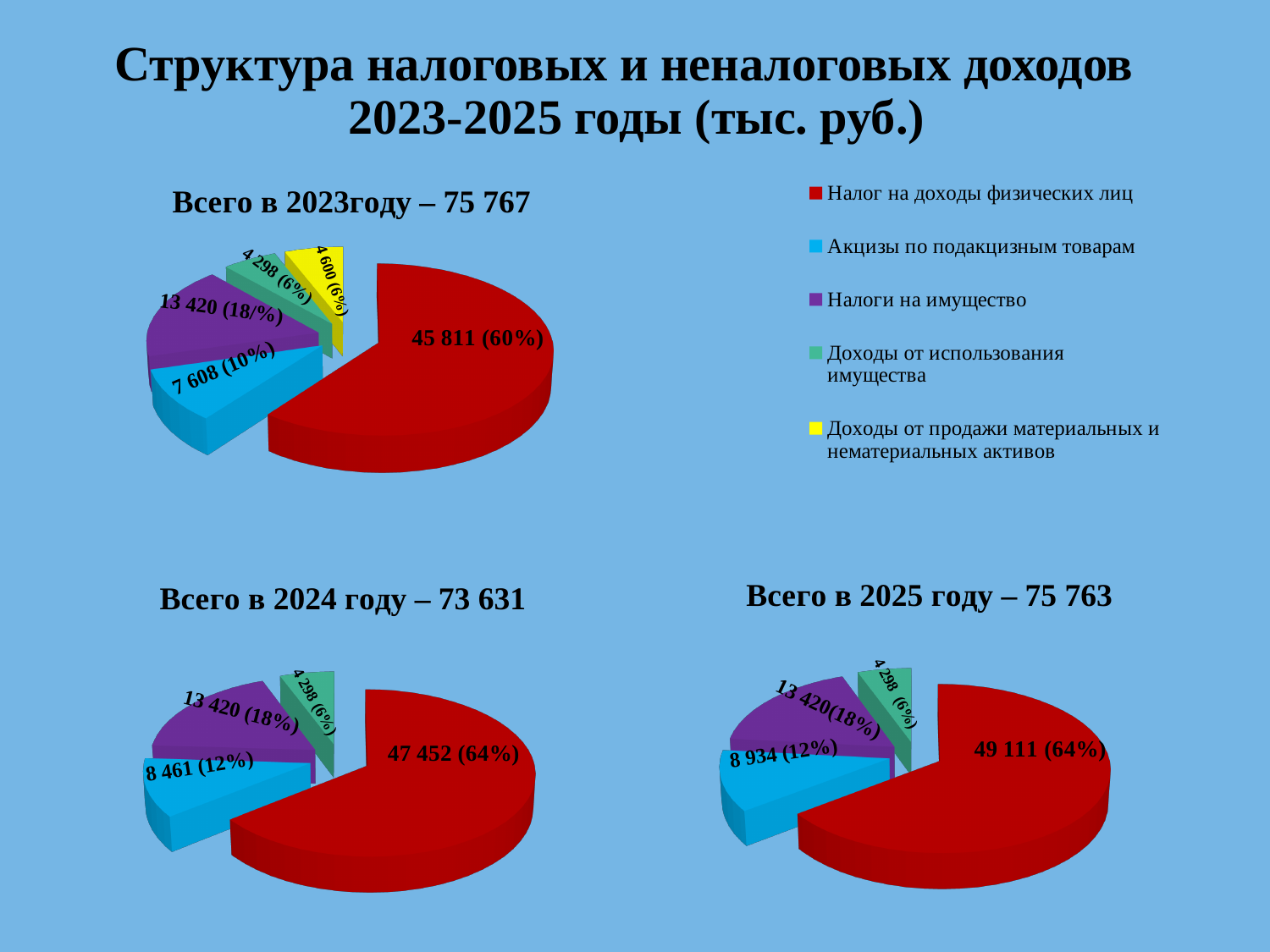
What type of chart is used for the 2023 data ("Всего в 2023году – 75 767")? Pie chart In the 2024 pie chart, which category has the largest slice? Налог на доходы физических лиц In the 2025 pie chart, what share does Налог на доходы физических лиц have? 64% In the 2025 pie chart, what is the difference between Налог на доходы физических лиц and Налоги на имущество? 35 691 In the 2024 pie chart, what is the value for Акцизы по подакцизным товарам? 8 461 In the 2023 pie chart, what is the value for Налог на доходы физических лиц? 45 811 In the 2024 pie chart, which category has the smallest slice? Доходы от использования имущества In the 2023 pie chart, what share does Акцизы по подакцизным товарам have? 10% Which is larger: Акцизы по подакцизным товарам in the 2025 pie chart or in the 2024 pie chart? 2025 (8 934) In the 2023 pie chart, what is the value for Доходы от продажи материальных и нематериальных активов? 4 600 How many slices does the 2025 pie chart have? 4 How many entries does the legend list? 5